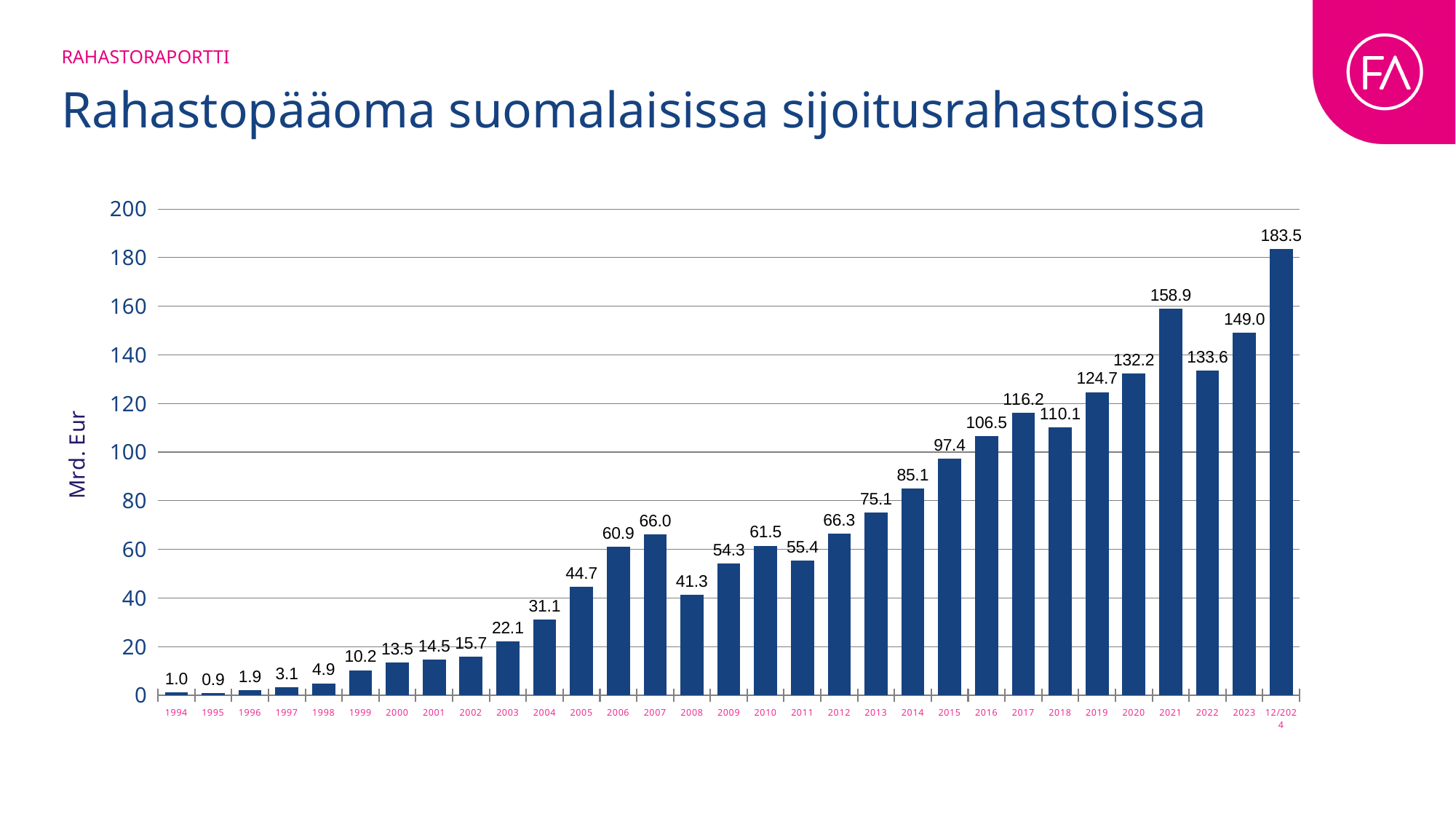
How many bars are plotted in the chart? 31 What is the difference between the values for 2007 and 2008? 24.7 What kind of chart is shown on the slide? bar chart What is the value for 1999? 10.2 What is the label on the vertical axis? Mrd. Eur Is the value for 2017 greater or less than 100? greater Which year has the highest value? 12/2024 Which year has the lowest value? 1995 What is the difference between the values for 12/2024 and 2023? 34.5 Which is larger, the value for 2020 or the value for 2022? 2022 What is the value for 2021? 158.9 What is the value for 2008? 41.3